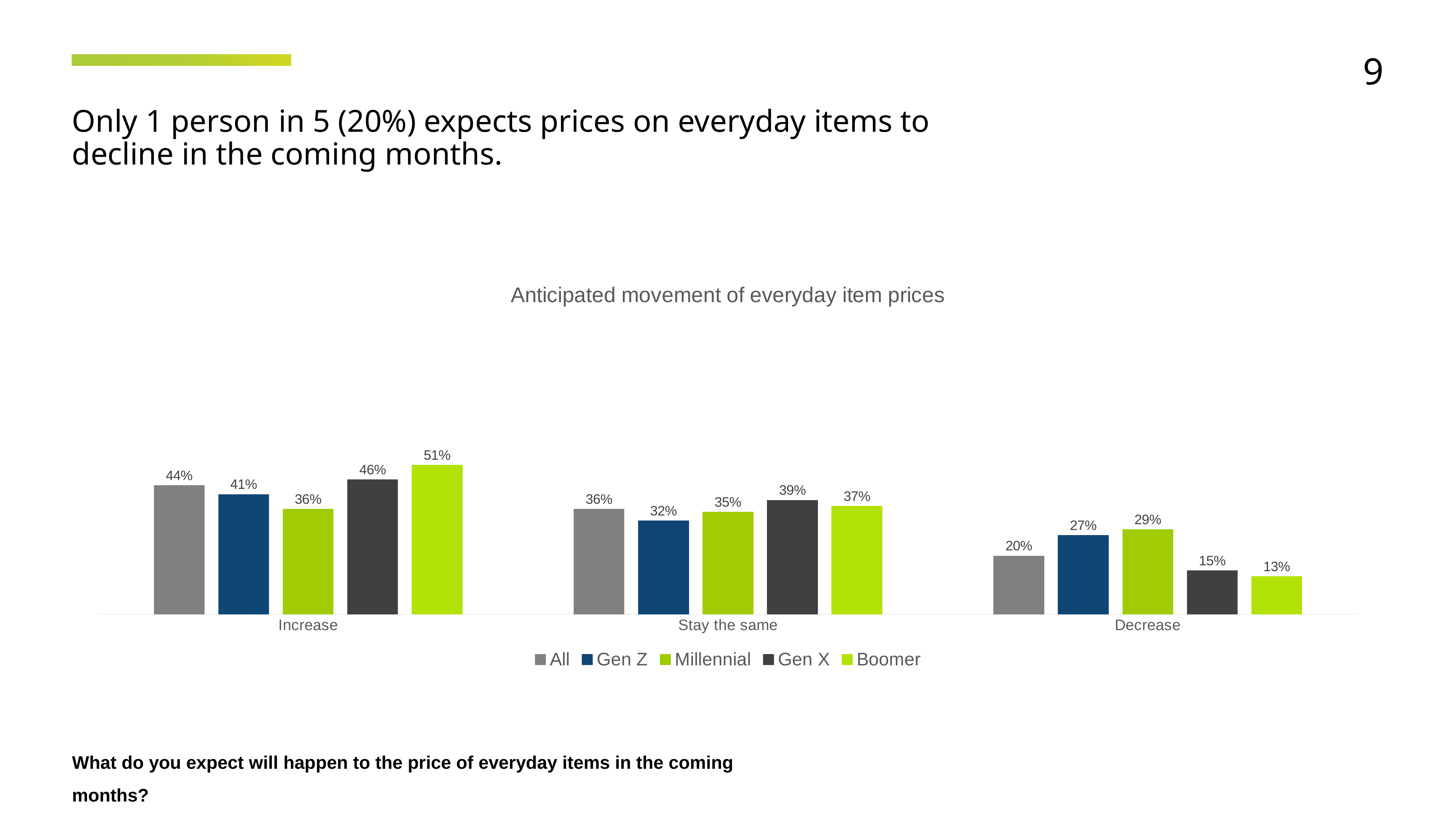
Which is larger in the Decrease category: Gen Z or Gen X? Gen Z What kind of chart is shown on the slide? Bar chart Which series has the lowest value in the Decrease category? Boomer What is the difference between the Boomer and Millennial values in the Increase category? 15% What is the value for Boomer in the Increase category? 51% What is the value for All in the Decrease category? 20% What is the title of the chart? Anticipated movement of everyday item prices How many categories are shown on the x axis? 3 What is the difference between the Millennial and Gen X values in the Decrease category? 14% How many series does the legend list? 5 Which series has the highest value in the Increase category? Boomer What is the value for Gen Z in the Stay the same category? 32%